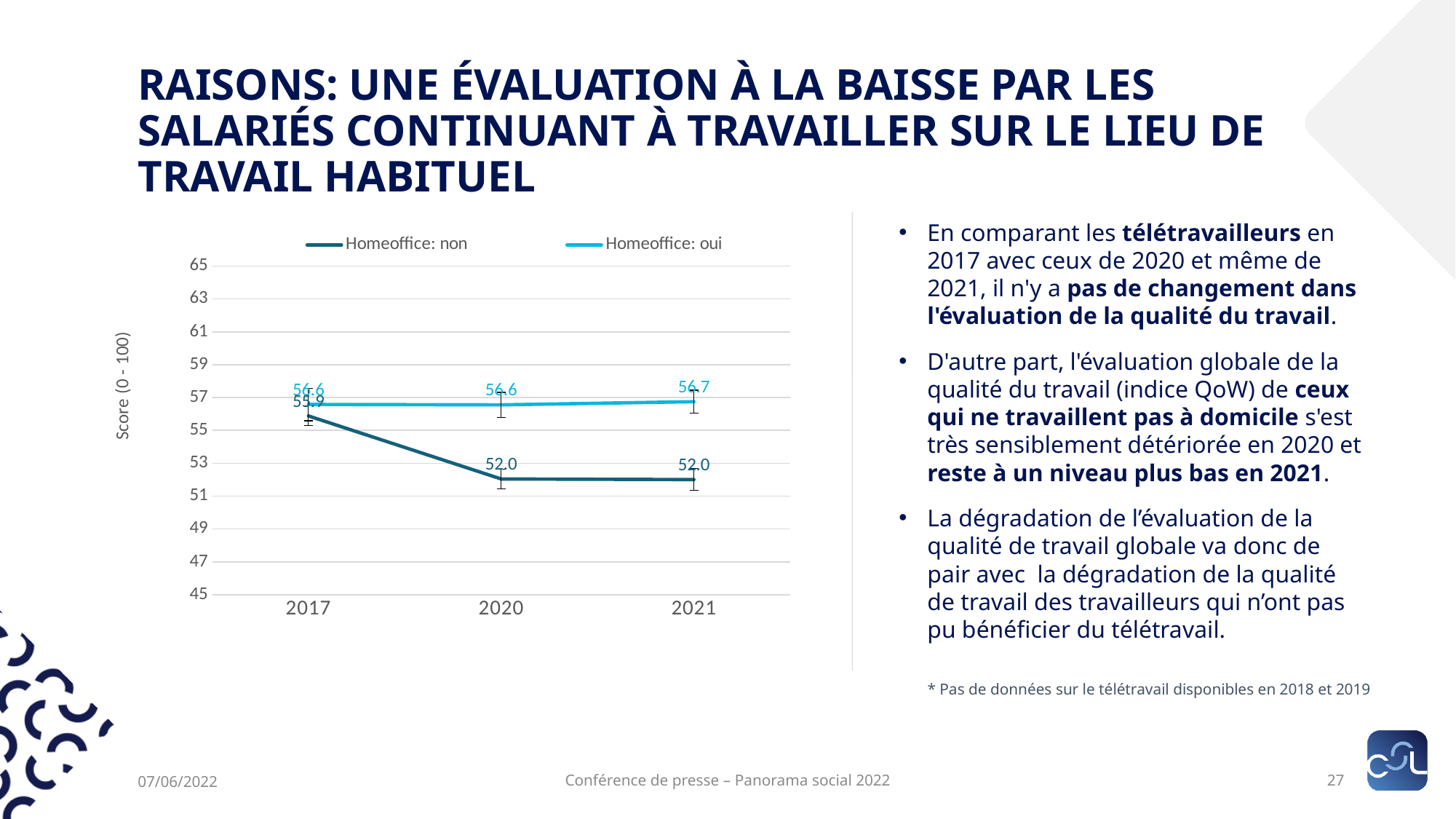
What is the value for 'Homeoffice: non' in 2020? 52.0 Which series has the larger value in 2020, 'Homeoffice: non' or 'Homeoffice: oui'? Homeoffice: oui What is the label of the y axis? Score (0 - 100) What is the value for 'Homeoffice: oui' in 2021? 56.7 Does the 'Homeoffice: non' series rise or fall from 2017 to 2020? fall In which year is the value for 'Homeoffice: non' highest? 2017 What is the difference between 'Homeoffice: oui' and 'Homeoffice: non' in 2021? 4.7 What is the value for 'Homeoffice: oui' in 2020? 56.6 What is the value for 'Homeoffice: non' in 2017? 55.9 How many years are shown on the x axis? 3 How many series does the legend list? 2 What type of chart is shown on the slide? line chart